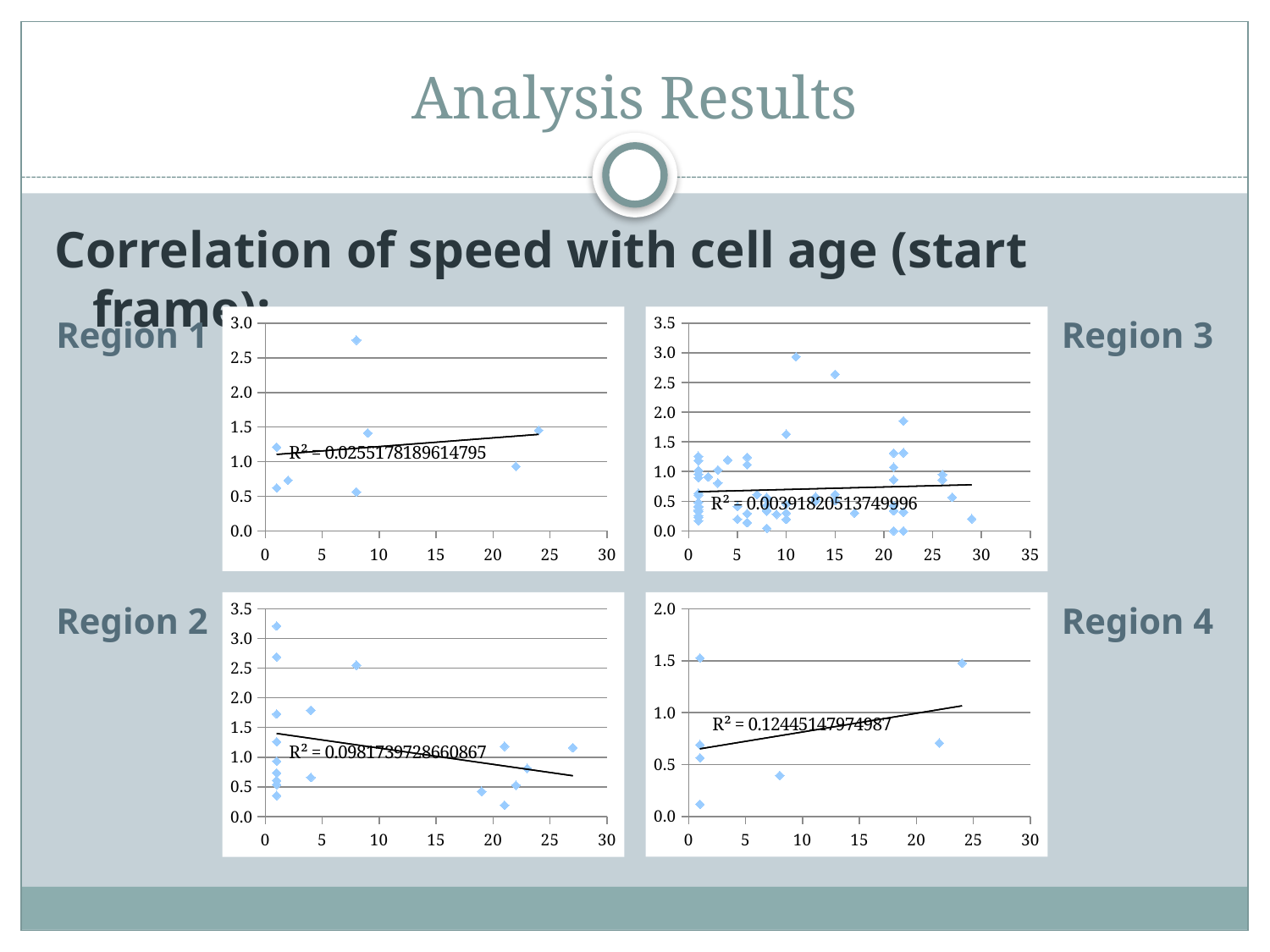
Which region's chart shows the highest R² value? Region 4 Which region's chart shows the lowest R² value? Region 3 In the Region 4 chart, does the trend line rise or fall as the x value increases? Rise What kind of chart is used for Region 1? Scatter chart In the Region 3 chart, what R² value is printed? R² = 0.00391820513749996 In the Region 2 chart, does the trend line rise or fall as the x value increases? Fall In the Region 4 chart, what R² value is printed? R² = 0.12445147974987 How many charts are shown on the slide? 4 In the Region 1 chart, is the highest plotted point greater or less than 2.5? greater In the Region 1 chart, what R² value is printed? R² = 0.0255178189614795 In the Region 2 chart, what R² value is printed? R² = 0.0981739728660867 In the Region 3 chart, what is the maximum value shown on the x axis? 35